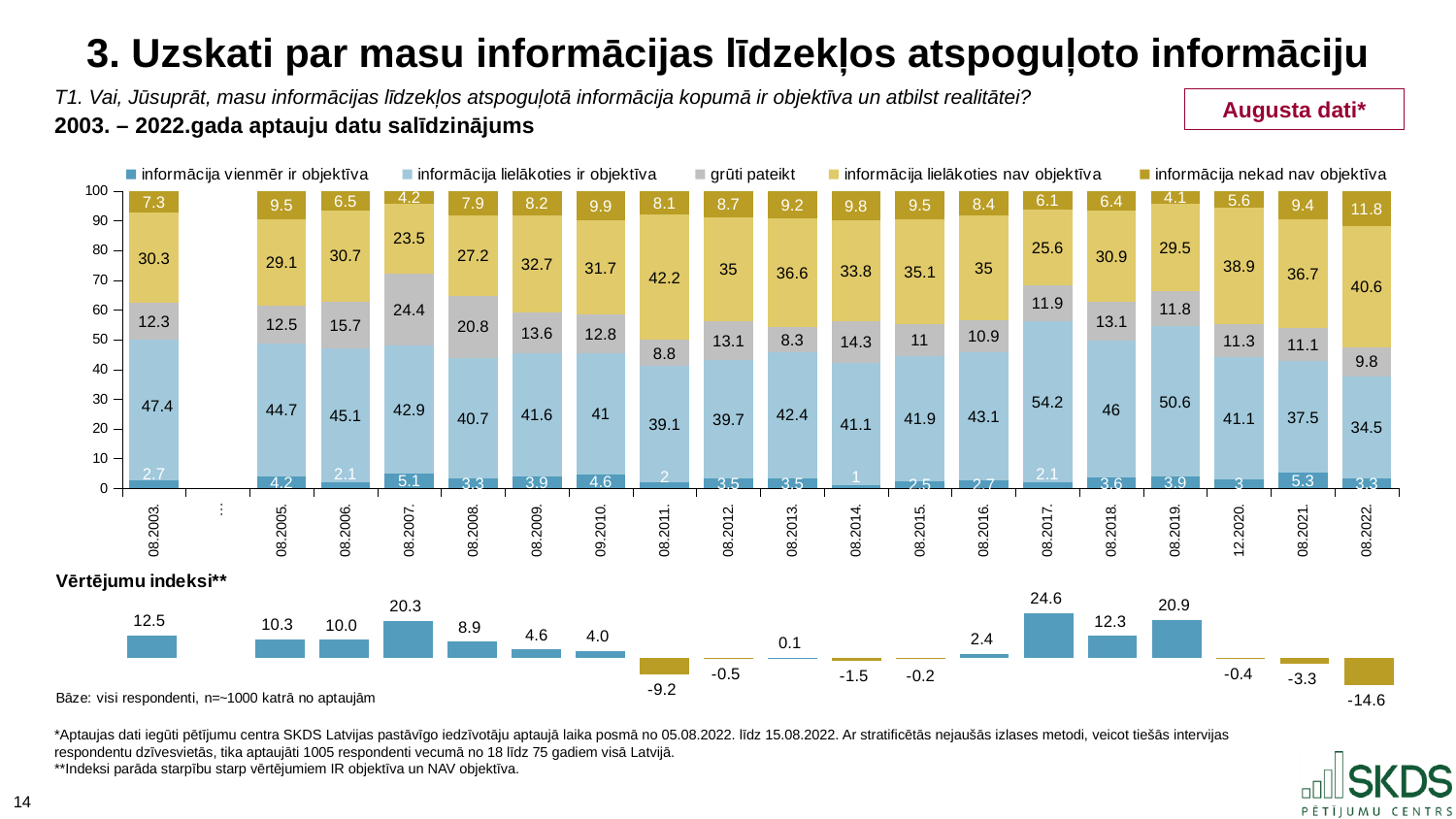
In the top stacked chart, what kind of chart is it? stacked bar chart In the top stacked chart, what is the total of the stacked bar for 08.2022? 100 In the bottom 'Vērtējumu indeksi' chart, what is the index value for 08.2007? 20.3 In the bottom 'Vērtējumu indeksi' chart, which survey wave has the highest index? 08.2017 In the top stacked chart, which has the larger 'grūti pateikt' value, 08.2007 or 08.2022? 08.2007 In the top stacked chart, how many series does the legend list? 5 In the top stacked chart, what is the difference between the 'informācija lielākoties nav objektīva' values for 08.2022 and 08.2003? 10.3 In the top stacked chart, what is the value for 'informācija vienmēr ir objektīva' in 08.2021? 5.3 In the bottom 'Vērtējumu indeksi' chart, which survey wave has the lowest index? 08.2022 In the top stacked chart, how many survey waves (bars) are plotted? 19 In the top stacked chart, what is the value for 'informācija lielākoties ir objektīva' in 08.2017? 54.2 In the top stacked chart, what is the value for 'informācija nekad nav objektīva' in 08.2022? 11.8